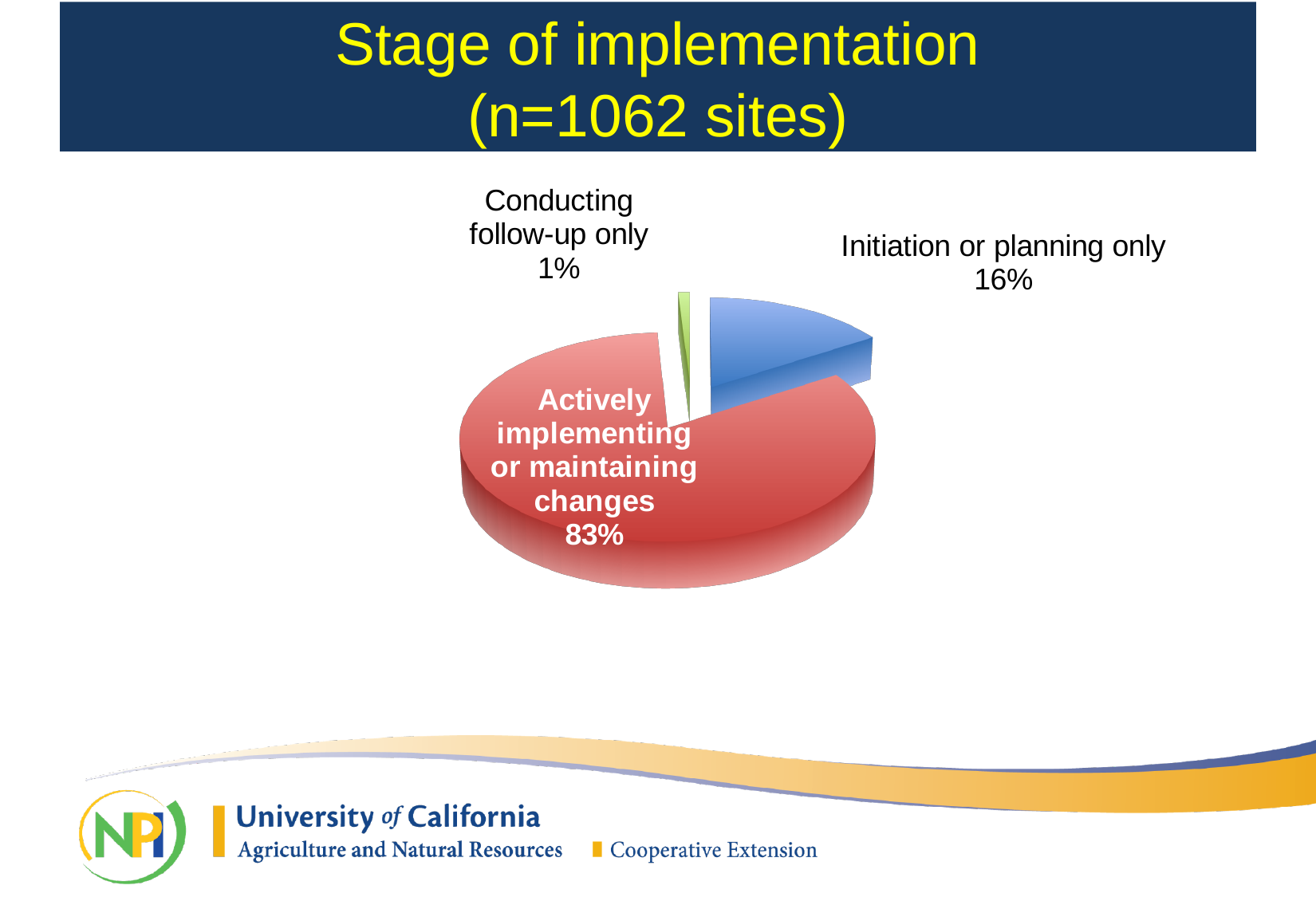
What is the title of the chart? Stage of implementation (n=1062 sites) What is the difference in percentage points between 'Initiation or planning only' and 'Conducting follow-up only'? 15 What share of sites are conducting follow-up only? 1% What is the difference in percentage points between the 'Actively implementing or maintaining changes' slice and the 'Initiation or planning only' slice? 67 Which is larger: the share for 'Initiation or planning only' or the share for 'Conducting follow-up only'? Initiation or planning only What kind of chart is shown on the slide? pie chart What share of sites are in the initiation or planning only stage? 16% How many slices does the pie chart have? 3 Which stage of implementation has the smallest share of sites? Conducting follow-up only What colour is the 'Initiation or planning only' slice? blue Which stage of implementation has the largest share of sites? Actively implementing or maintaining changes What share of sites are actively implementing or maintaining changes? 83%